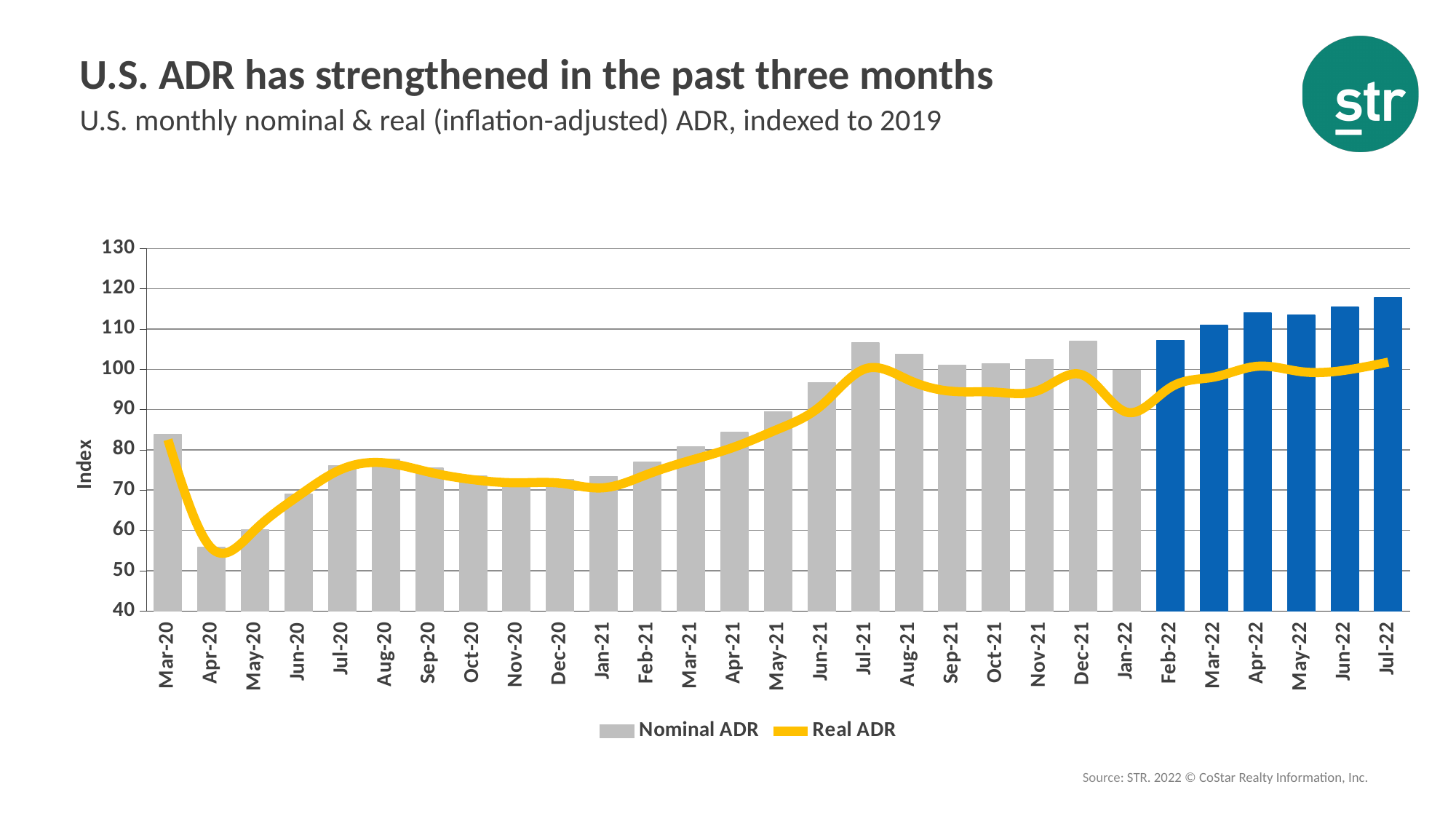
Is the Real ADR value for Mar-20 greater or less than 80? greater Which month has the lowest Nominal ADR bar? Apr-20 What are the two series named in the legend? Nominal ADR and Real ADR What kind of chart is shown on the slide? Bar chart with a line Is the Nominal ADR value for Jul-22 greater or less than 110? greater Is the Nominal ADR value for Jun-21 greater or less than 100? less How many months are shown on the x axis? 29 Which has the larger Nominal ADR, Jul-21 or Jul-22? Jul-22 Which month has the highest Nominal ADR bar? Jul-22 Does the Nominal ADR rise or fall from Mar-20 to Apr-20? Fall How many series does the legend list? 2